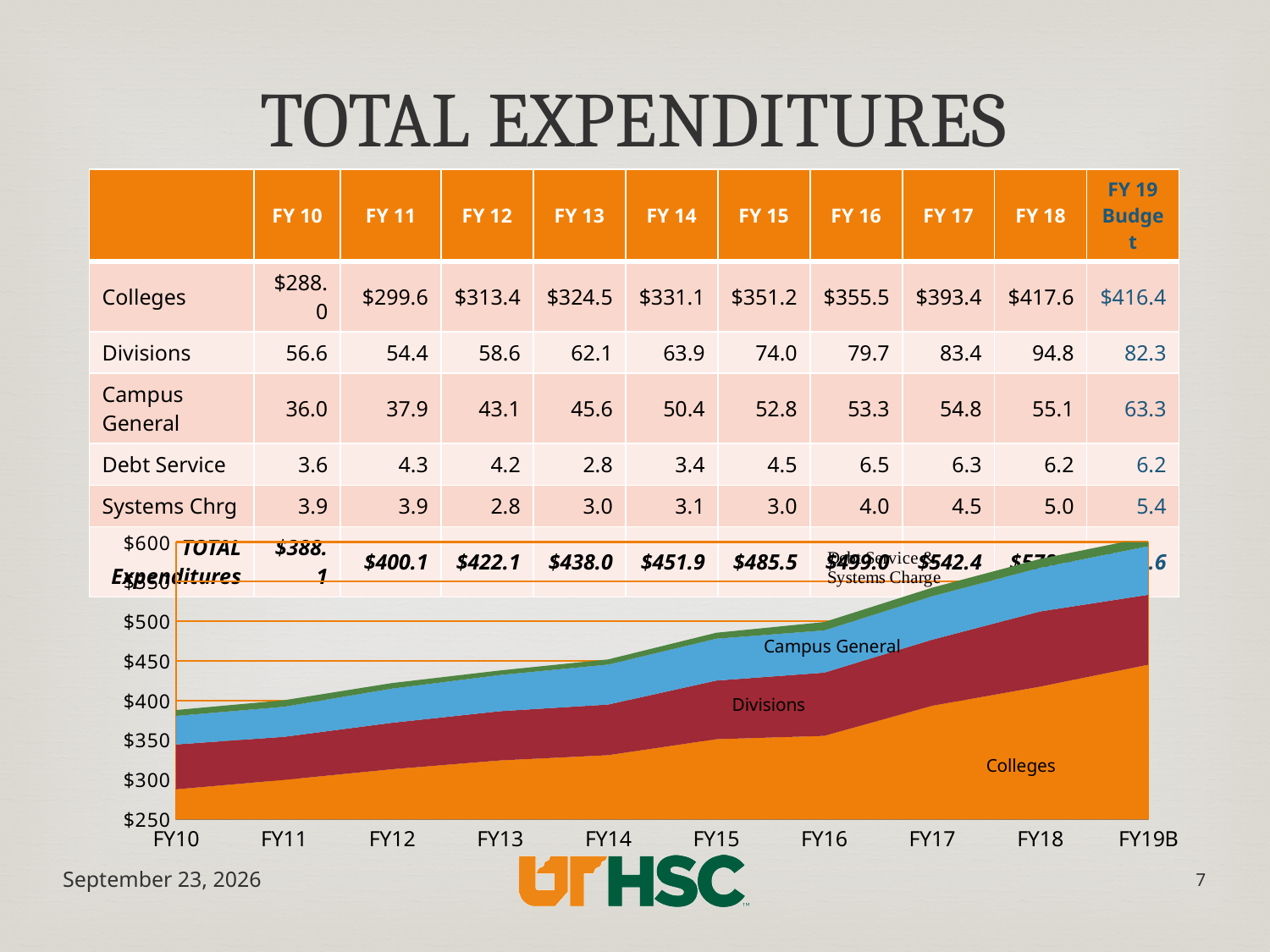
How many fiscal years are shown along the x axis of the chart? 10 Do total expenditures rise or fall from FY10 to FY19B in the chart? Rise What is the difference between the total expenditures for FY17 and FY16? $43.4 Is the total expenditure for FY19B greater or less than $550? greater What kind of chart is shown at the bottom of the slide? Stacked area chart Is the total expenditure for FY10 greater or less than $400? less Which fiscal year has the highest total expenditure in the chart? FY19B What label appears on the thin green layer at the top of the stacked area chart? Debt Service & Systems Charge What is the total expenditure for FY17 as shown on the slide? $542.4 Is the total expenditure for FY12 greater or less than $400? greater Which fiscal year has the lowest total expenditure in the chart? FY10 Which series forms the bottom (orange) layer of the stacked area chart? Colleges